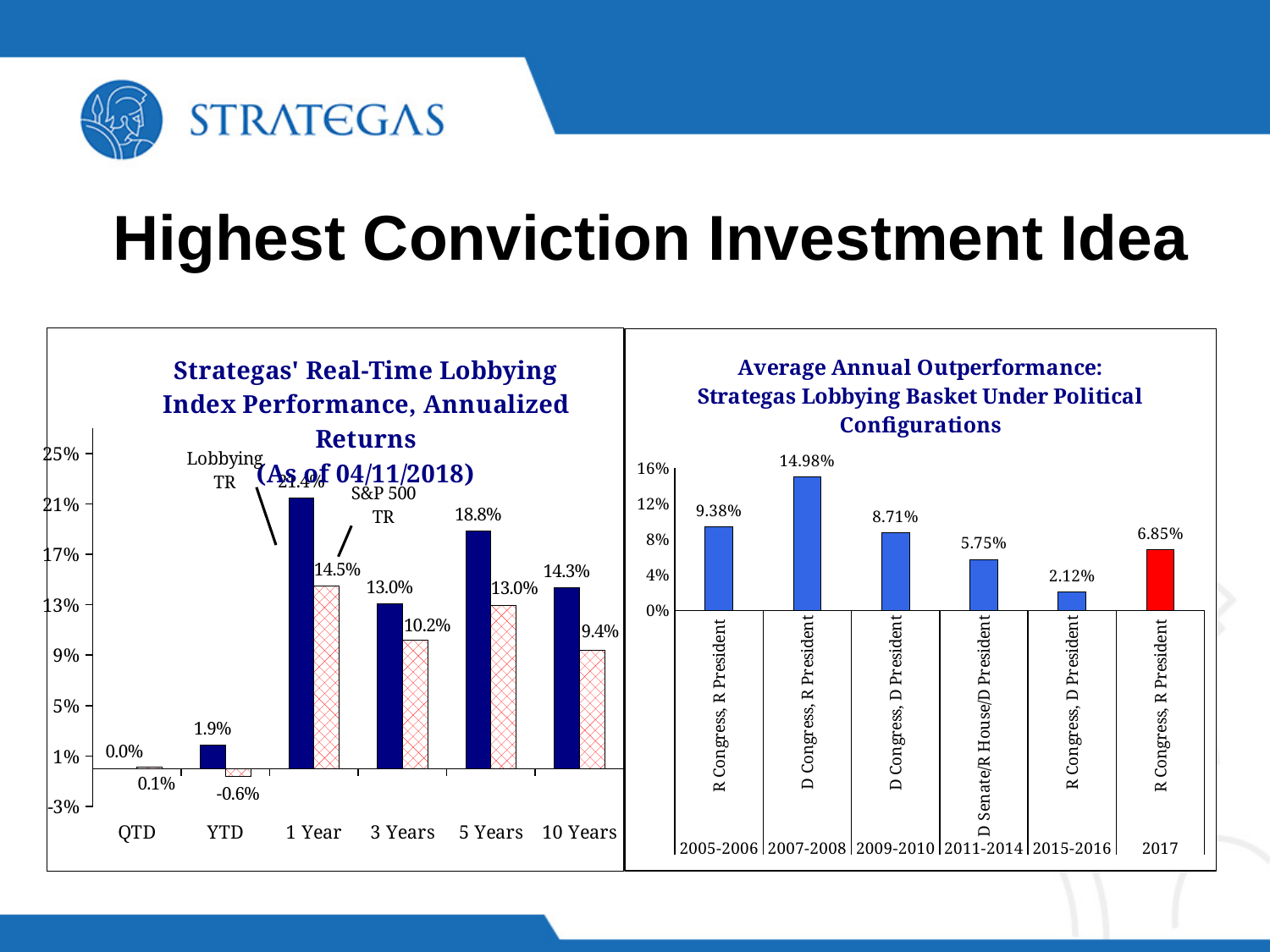
In the right chart, 'Average Annual Outperformance', which period has the lowest value? 2015-2016 In the right chart, 'Average Annual Outperformance', which period has the highest value? 2007-2008 In the left chart, 'Strategas' Real-Time Lobbying Index Performance', which is larger for 3 Years: Lobbying TR or S&P 500 TR? Lobbying TR In the left chart, 'Strategas' Real-Time Lobbying Index Performance', what is the Lobbying TR value for 5 Years? 18.8% In the right chart, 'Average Annual Outperformance', what is the difference between the 2005-2006 value and the 2009-2010 value? 0.67% What kind of chart is the left chart, 'Strategas' Real-Time Lobbying Index Performance'? bar chart How many periods are shown in the right chart, 'Average Annual Outperformance'? 6 In the left chart, 'Strategas' Real-Time Lobbying Index Performance', is the Lobbying TR value for 1 Year greater or less than 17%? greater In the left chart, 'Strategas' Real-Time Lobbying Index Performance', what is the S&P 500 TR value for YTD? -0.6% In the right chart, 'Average Annual Outperformance', what is the value for 2007-2008 (D Congress, R President)? 14.98% In the right chart, 'Average Annual Outperformance', what is the value for 2017 (R Congress, R President)? 6.85% In the left chart, 'Strategas' Real-Time Lobbying Index Performance', what is the difference between Lobbying TR and S&P 500 TR for 10 Years? 4.9%